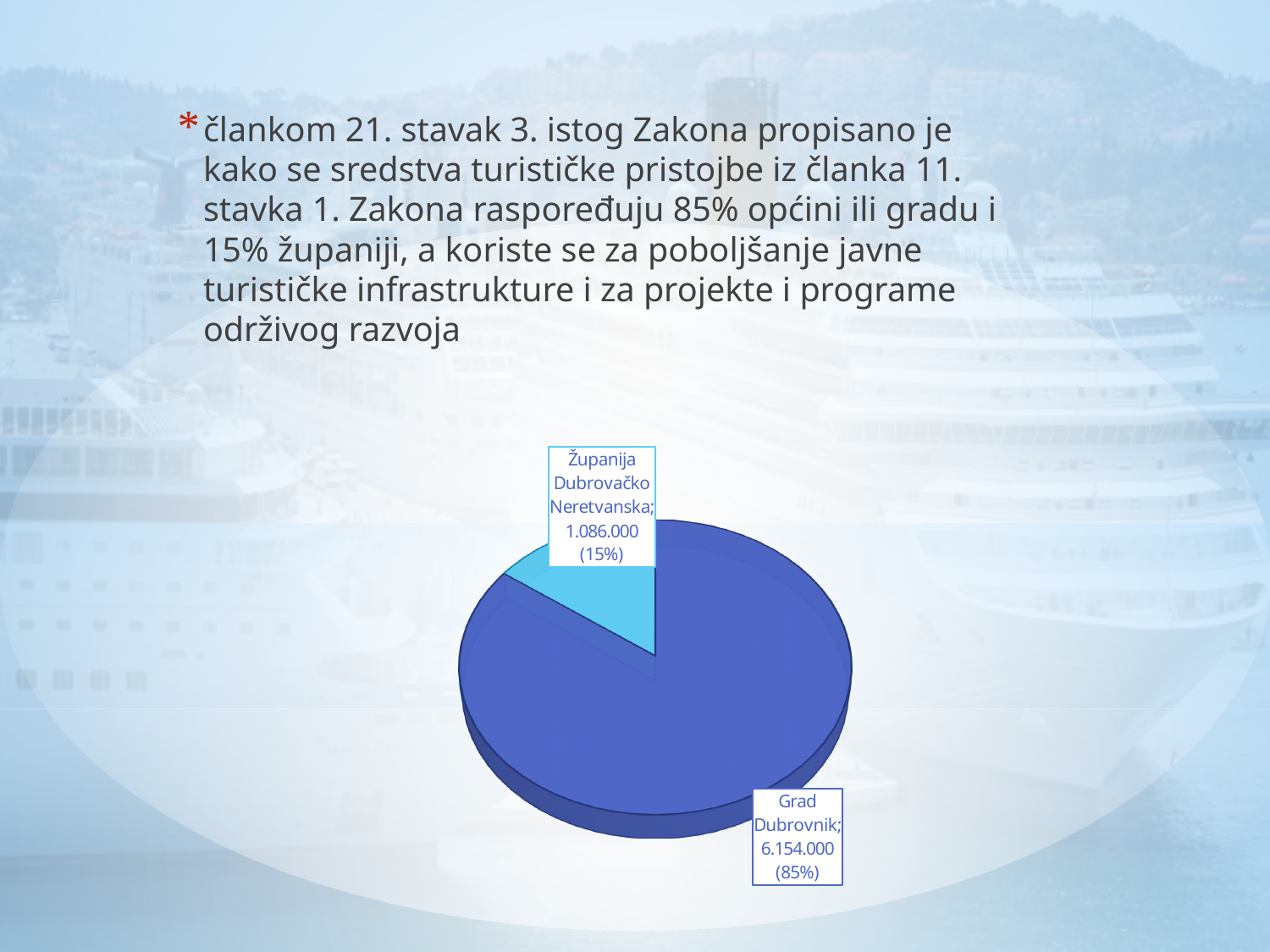
How many slices does the pie chart have? 2 Which slice is the smallest? Županija Dubrovačko Neretvanska What share of the pie does Grad Dubrovnik represent? 85% Which is larger, the value for Grad Dubrovnik or the value for Županija Dubrovačko Neretvanska? Grad Dubrovnik What kind of chart is shown on the slide? pie chart What colour is the slice for Županija Dubrovačko Neretvanska? light blue (cyan) What is the value for Grad Dubrovnik? 6.154.000 What is the difference between the values for Grad Dubrovnik and Županija Dubrovačko Neretvanska? 5.068.000 What is the total of the two slices in the pie chart? 7.240.000 What share of the pie does Županija Dubrovačko Neretvanska represent? 15% Which slice is the largest? Grad Dubrovnik What is the value for Županija Dubrovačko Neretvanska? 1.086.000